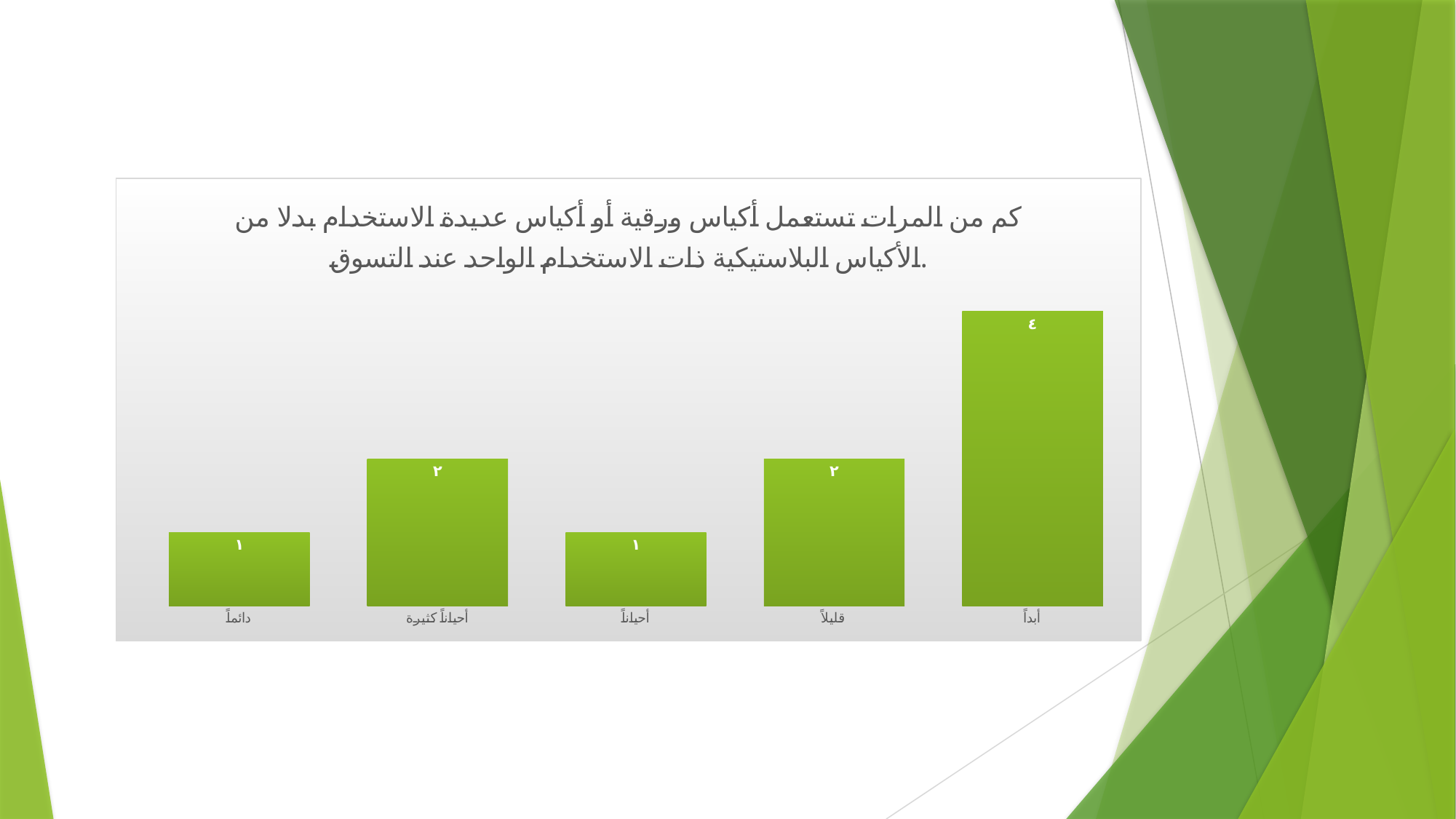
Which category has the highest value? أبداً What colour are the bars in the chart? Green What value is shown for the category دائماً? ١ Which is larger, the value for أبداً or the value for دائماً? أبداً What value is shown for the category أبداً? ٤ What kind of chart is shown on the slide? Bar chart What value is shown for the category قليلاً? ٢ How many categories are shown in the chart? 5 What is the difference between the values for أبداً and قليلاً? ٢ What is the total of all the values shown in the chart? ١٠ What value is shown for the category أحياناً كثيرة? ٢ What is the difference between the values for أحياناً كثيرة and أحياناً? ١